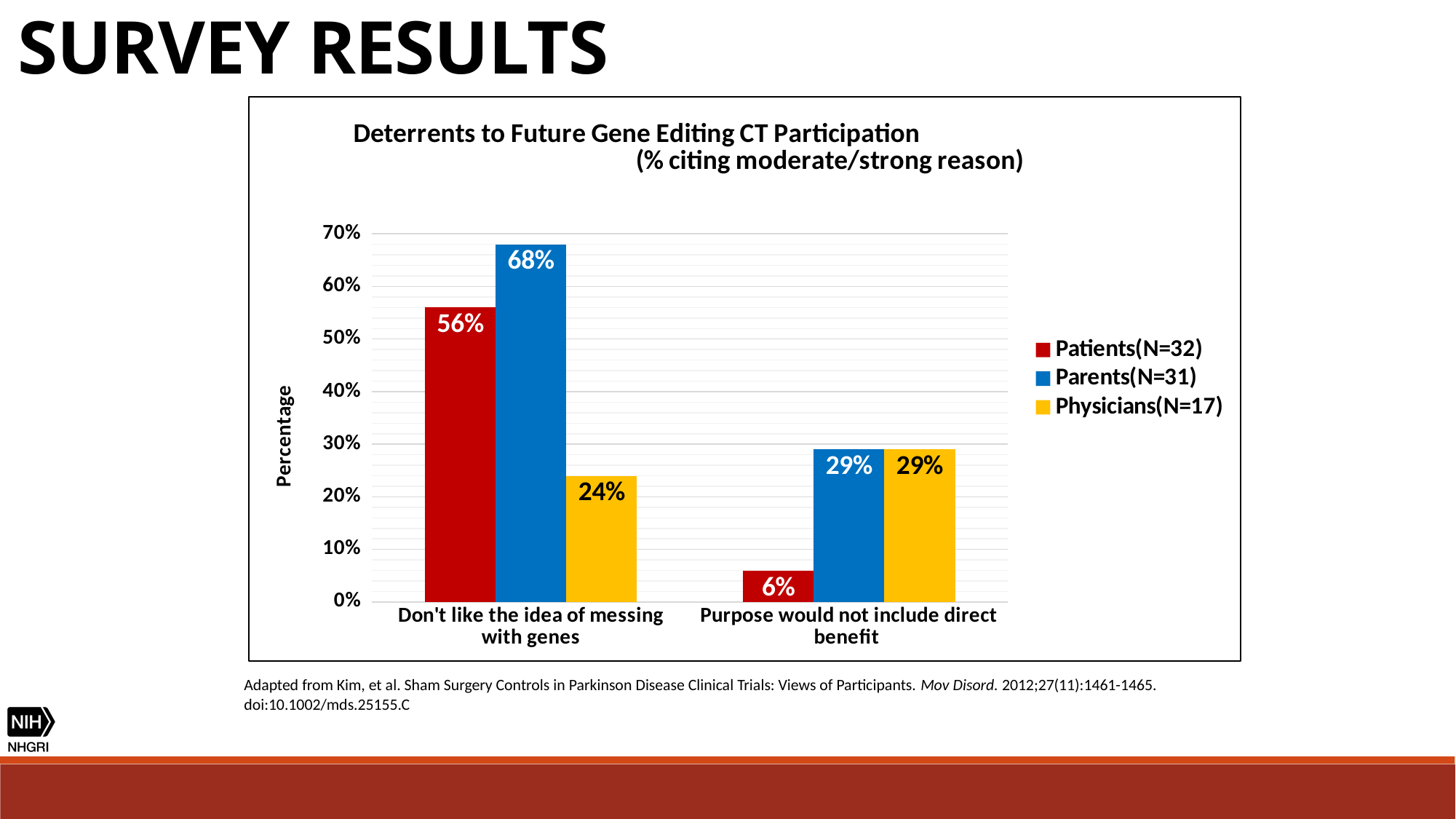
What kind of chart is shown on the slide? Bar chart Which group has the highest value for "Don't like the idea of messing with genes"? Parents(N=31) What percentage of Physicians(N=17) cited "Purpose would not include direct benefit"? 29% How many series does the legend list? 3 What percentage of Parents(N=31) cited "Don't like the idea of messing with genes"? 68% What is the difference between the Parents and Physicians values for "Don't like the idea of messing with genes"? 44% Which is larger: the Patients value for "Don't like the idea of messing with genes" or the Physicians value for the same deterrent? Patients How many deterrent categories are shown on the x axis? 2 What is the difference between the Patients values for the two deterrents? 50% Which group has the lowest value for "Purpose would not include direct benefit"? Patients(N=32) What percentage of Patients(N=32) cited "Purpose would not include direct benefit"? 6% What percentage of Patients(N=32) cited "Don't like the idea of messing with genes" as a moderate/strong reason? 56%